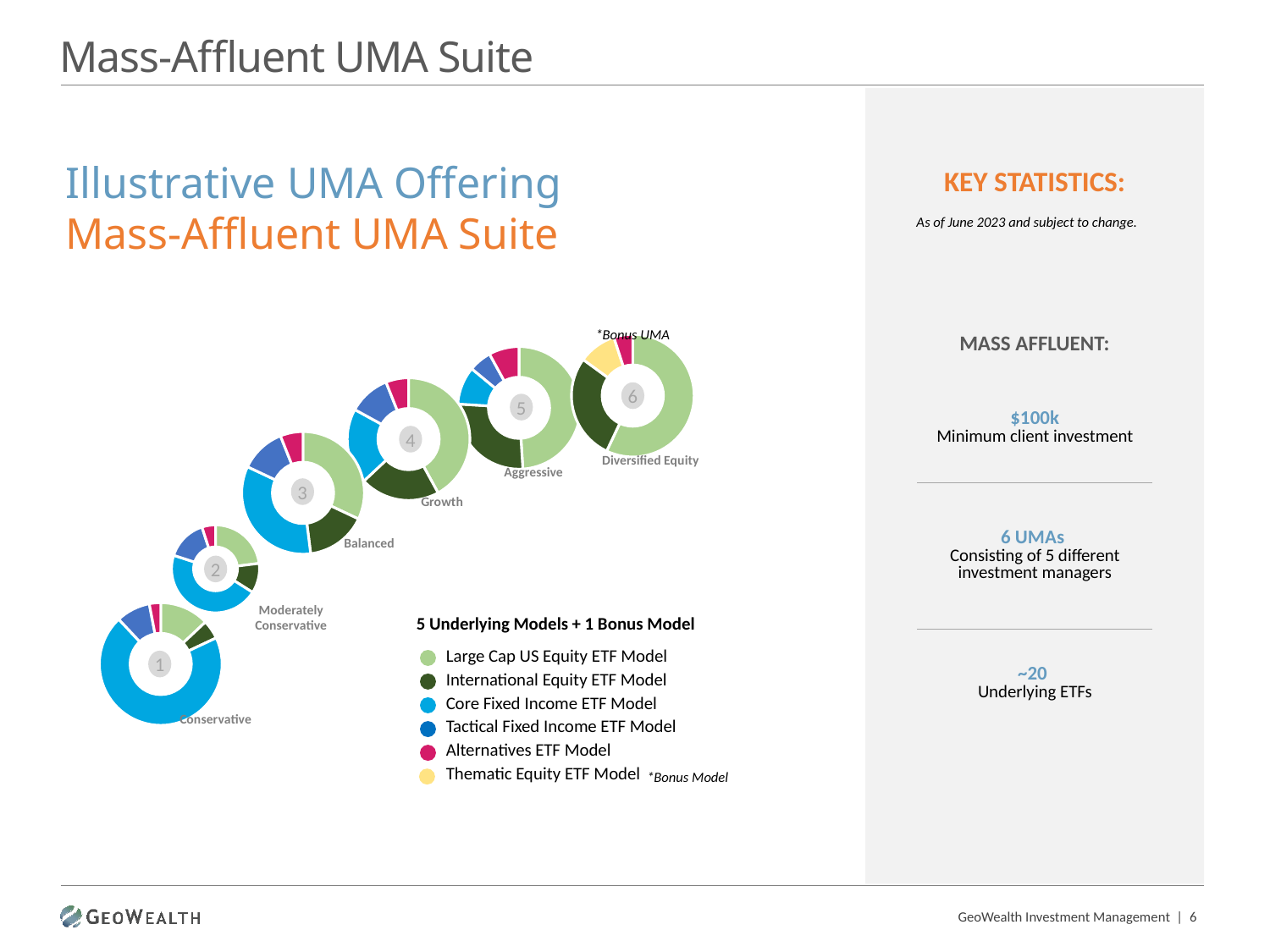
In the Diversified Equity donut chart, which is larger: the Large Cap US Equity ETF Model share or the International Equity ETF Model share? Large Cap US Equity ETF Model What kind of chart is used to show each UMA's model allocation? Pie (donut) chart Which donut chart has the largest share of Core Fixed Income ETF Model? Conservative Which donut chart is marked as the Bonus UMA? Diversified Equity (chart 6) Which donut chart is the only one that includes the Thematic Equity ETF Model? Diversified Equity In the Conservative donut chart, which is larger: the Core Fixed Income ETF Model share or the Large Cap US Equity ETF Model share? Core Fixed Income ETF Model Which donut chart has the largest share of Large Cap US Equity ETF Model? Diversified Equity What is the label of donut chart number 6? Diversified Equity Which model is marked as the Bonus Model in the legend? Thematic Equity ETF Model What is the label of donut chart number 3? Balanced How many donut charts are shown on the slide? 6 How many models does the legend list? 6